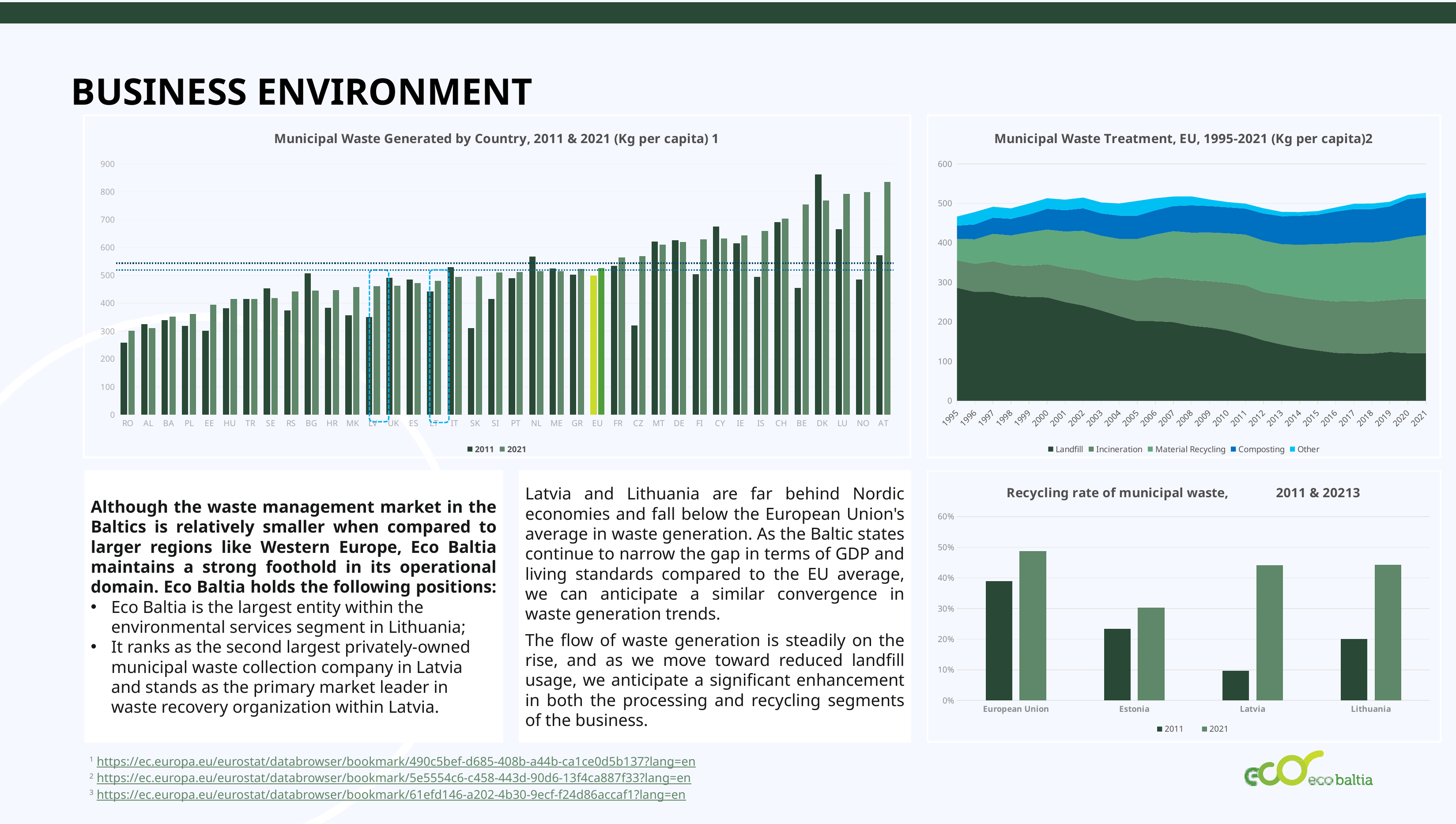
Which series are listed in the legend of the 'Municipal Waste Treatment, EU, 1995-2021' chart? Landfill, Incineration, Material Recycling, Composting, Other In the 'Municipal Waste Treatment, EU, 1995-2021' chart, does the Landfill series rise or fall from 1995 to 2021? fall What type of chart is the 'Municipal Waste Generated by Country, 2011 & 2021' chart? bar chart In the 'Recycling rate of municipal waste' chart, is the 2021 value for Estonia or Latvia larger? Latvia In the 'Municipal Waste Generated by Country' chart, is the 2011 value for DK greater or less than 800? greater How many series does the legend of the 'Municipal Waste Treatment, EU, 1995-2021' chart list? 5 How many series does the legend of the 'Municipal Waste Generated by Country' chart list? 2 In the 'Municipal Waste Generated by Country' chart, is the 2011 value for RO greater or less than 300? less How many categories are shown on the x axis of the 'Recycling rate of municipal waste' chart? 4 In the 'Municipal Waste Generated by Country' chart, which country has the highest 2011 value? DK In the 'Recycling rate of municipal waste' chart, which category has the lowest 2011 value? Latvia In the 'Municipal Waste Generated by Country' chart, which country has the lowest 2011 value? RO